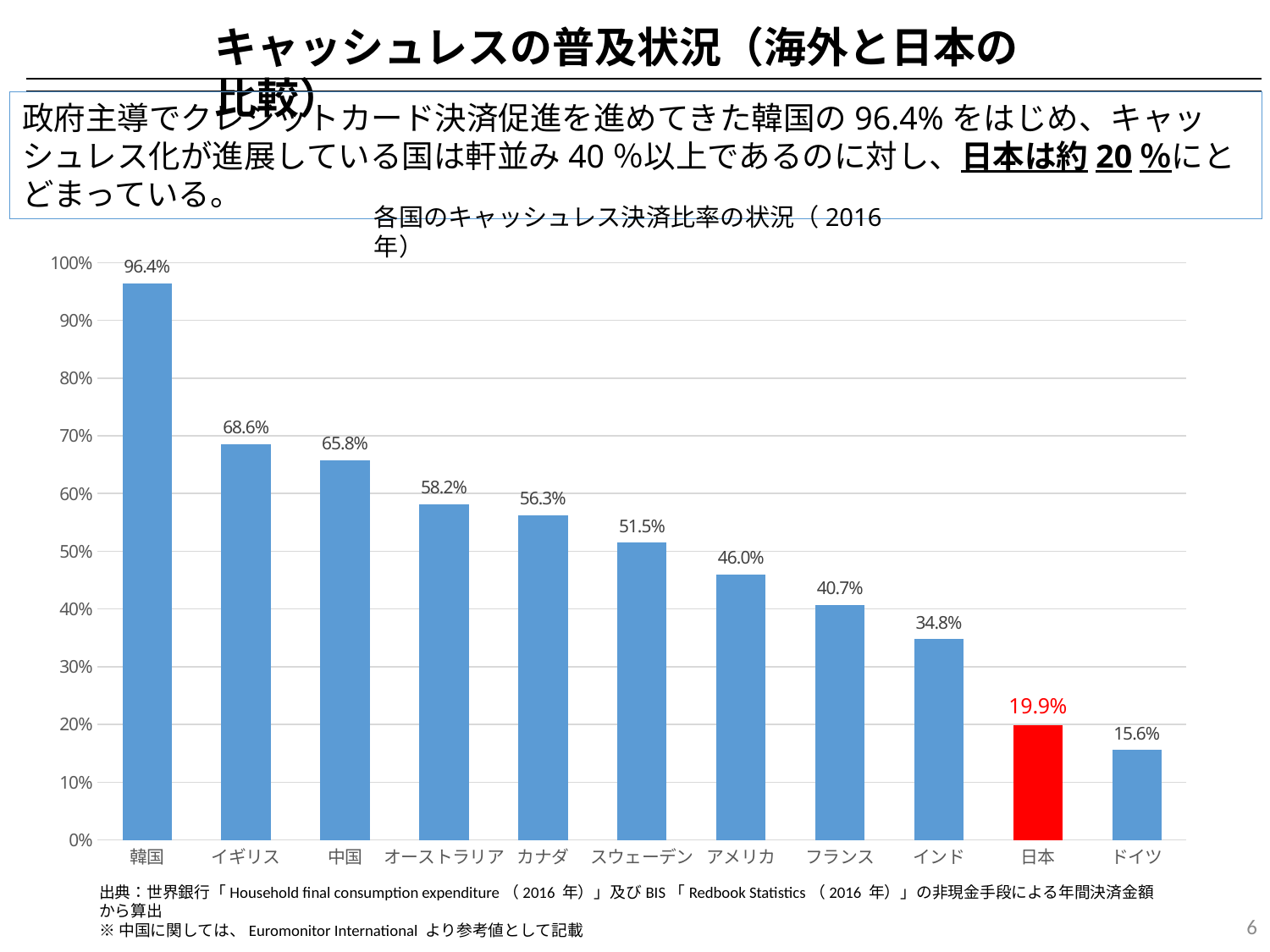
Is the value for インド greater or less than 40%? less What is the difference between the cashless payment ratios of 韓国 and 日本? 76.5% Which country has the lowest cashless payment ratio? ドイツ What kind of chart is shown on the slide? bar chart Which has a higher cashless payment ratio, アメリカ or フランス? アメリカ How many countries are shown in the chart? 11 Which country's bar is coloured red? 日本 What is the difference between the cashless payment ratios of イギリス and 中国? 2.8% What is the cashless payment ratio for 韓国 (Korea)? 96.4% Which country has the highest cashless payment ratio? 韓国 What is the cashless payment ratio for スウェーデン (Sweden)? 51.5% What is the cashless payment ratio for 日本 (Japan)? 19.9%